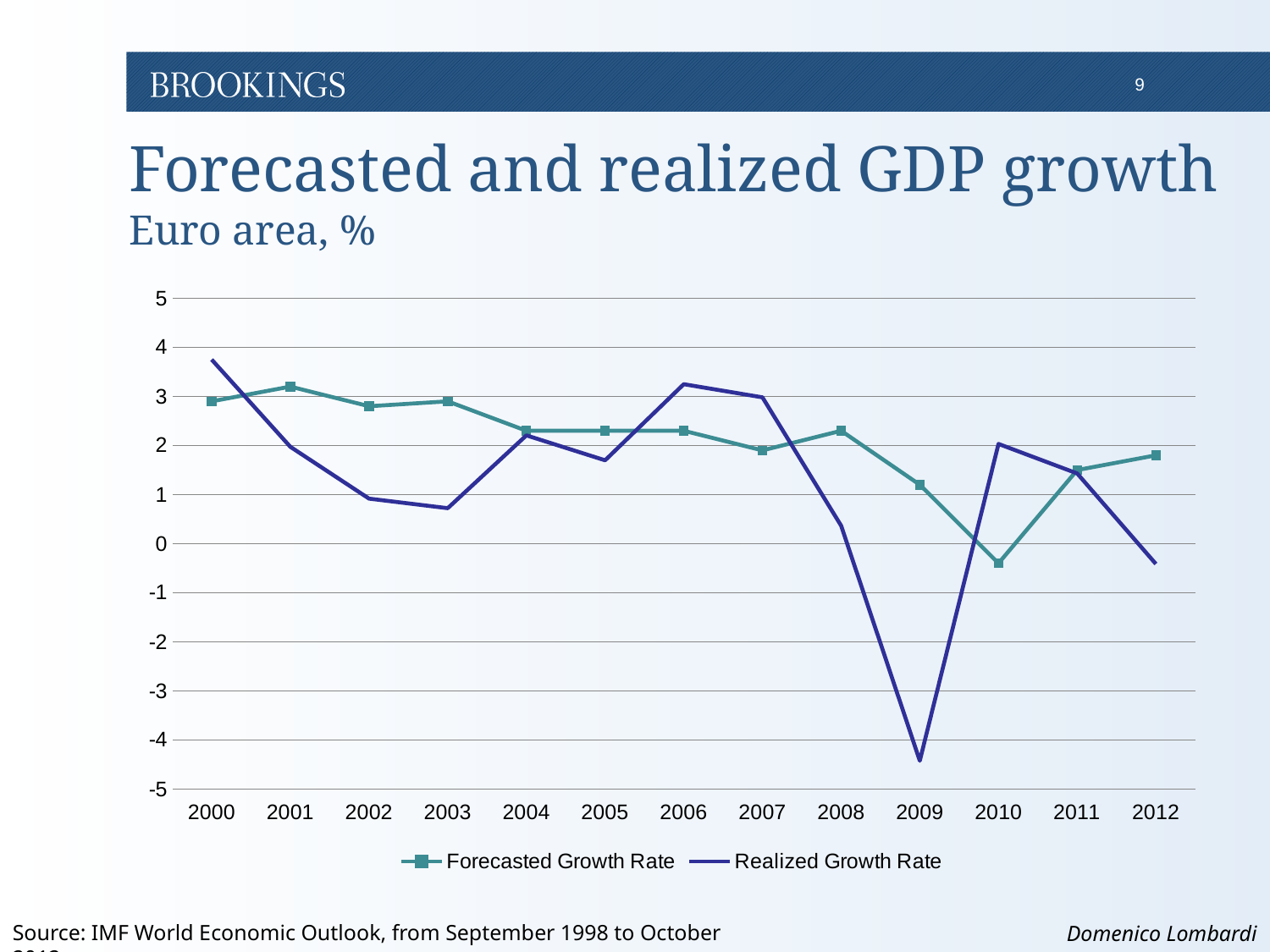
Is the Realized Growth Rate for 2000 greater or less than 3? greater Is the Realized Growth Rate for 2009 greater or less than -4? less What kind of chart is shown on the slide? Line chart Does the Realized Growth Rate rise or fall from 2006 to 2009? Fall How many series does the legend list? 2 In 2002, which is larger: the Forecasted Growth Rate or the Realized Growth Rate? Forecasted Growth Rate In which year is the Forecasted Growth Rate lowest? 2010 In which year is the Realized Growth Rate lowest? 2009 In 2006, which is larger: the Forecasted Growth Rate or the Realized Growth Rate? Realized Growth Rate Is the Forecasted Growth Rate for 2010 greater or less than 0? less How many years are plotted along the x axis? 13 In which year is the Realized Growth Rate highest? 2000